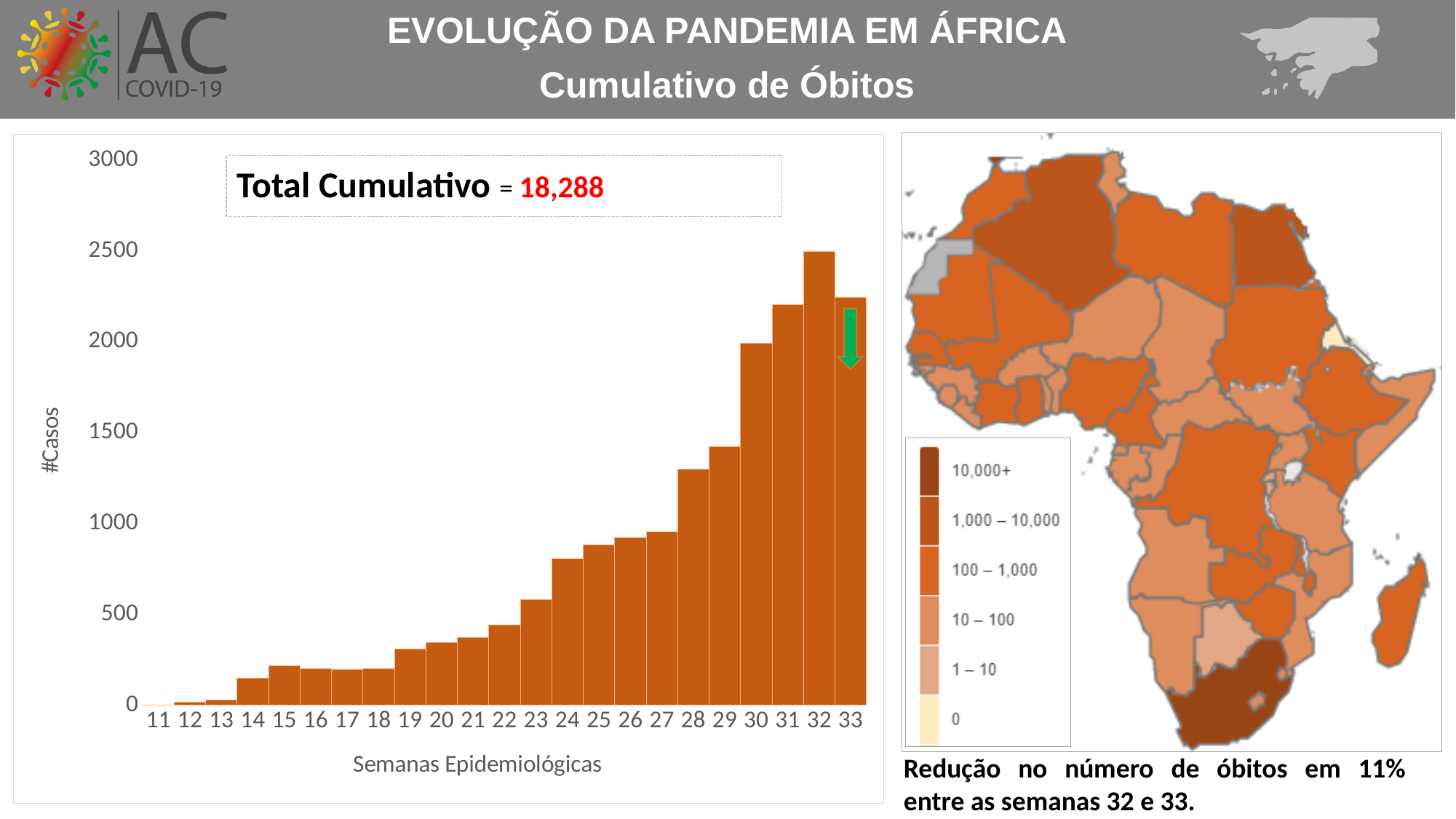
What is the 'Total Cumulativo' value printed on the chart? 18,288 Which epidemiological week has the highest bar in the chart? 32 Which week has the larger value, week 32 or week 33? week 32 Is the value for week 32 greater or less than 2000? greater Which epidemiological week has the lowest bar in the chart? 11 What kind of chart is shown on the left of the slide? bar chart Is the value for week 24 greater or less than 500? greater Is the value for week 14 greater or less than 500? less How many epidemiological weeks (bars) are plotted in the bar chart? 23 Do the values generally rise or fall from week 11 to week 32? rise Which week has the larger value, week 20 or week 25? week 25